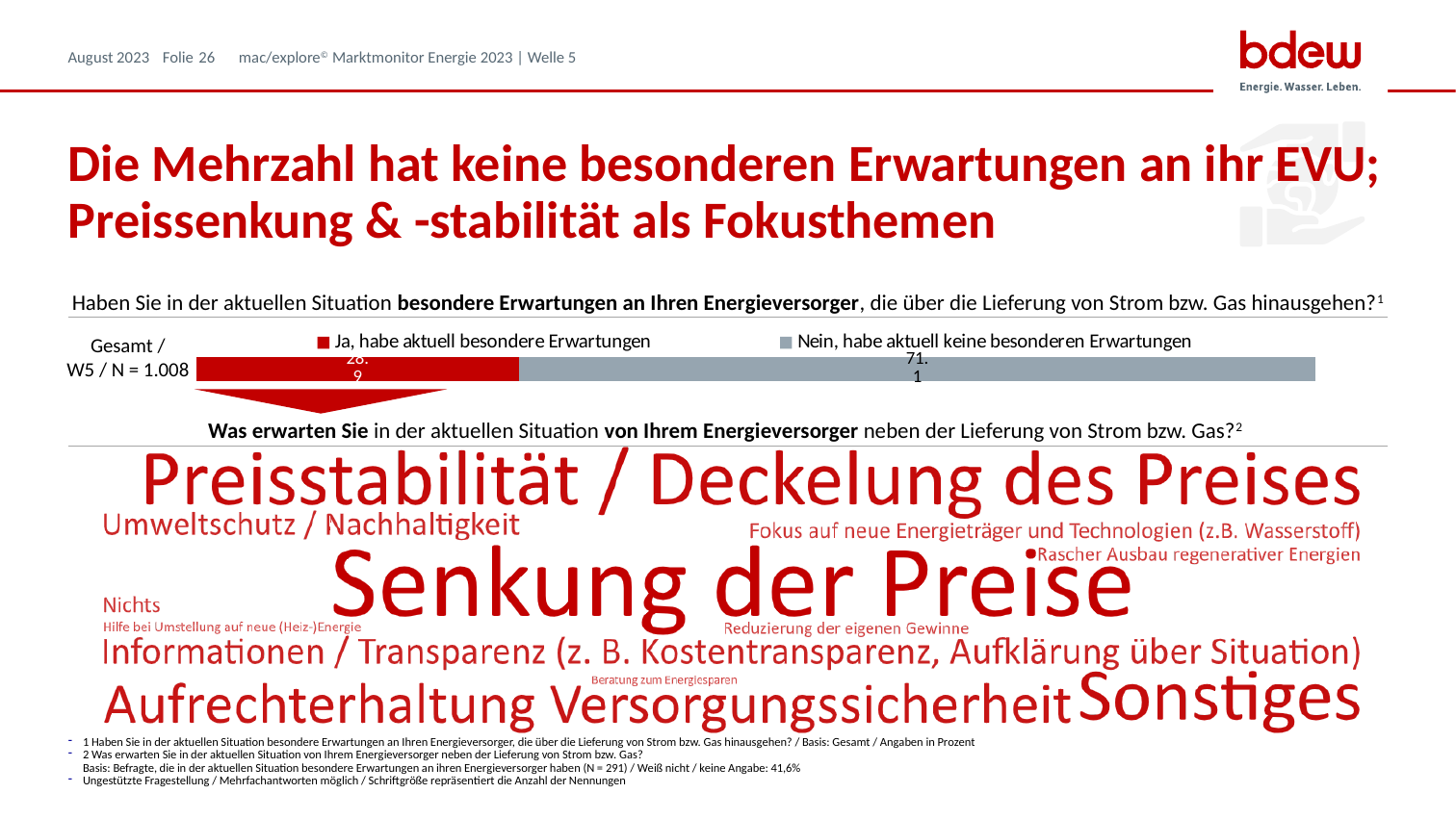
What colour is used for the series 'Ja, habe aktuell besondere Erwartungen' in the bar chart? red What is the value for 'Ja, habe aktuell besondere Erwartungen' in the bar chart? 28.9 What is the total of the two segments of the stacked bar? 100 What kind of chart is shown below the question 'Haben Sie in der aktuellen Situation besondere Erwartungen an Ihren Energieversorger'? bar chart How many series does the legend of the bar chart list? 2 What is the category label shown to the left of the stacked bar? Gesamt / W5 / N = 1.008 Is the value for 'Nein, habe aktuell keine besonderen Erwartungen' greater or less than 50? greater What is the value for 'Nein, habe aktuell keine besonderen Erwartungen' in the bar chart? 71.1 What is the difference between the 'Nein' value and the 'Ja' value in the bar chart? 42.2 In the bar chart, which is larger: 'Ja, habe aktuell besondere Erwartungen' or 'Nein, habe aktuell keine besonderen Erwartungen'? Nein, habe aktuell keine besonderen Erwartungen Which series takes up the largest part of the stacked bar? Nein, habe aktuell keine besonderen Erwartungen How many categories (bars) does the bar chart show? 1